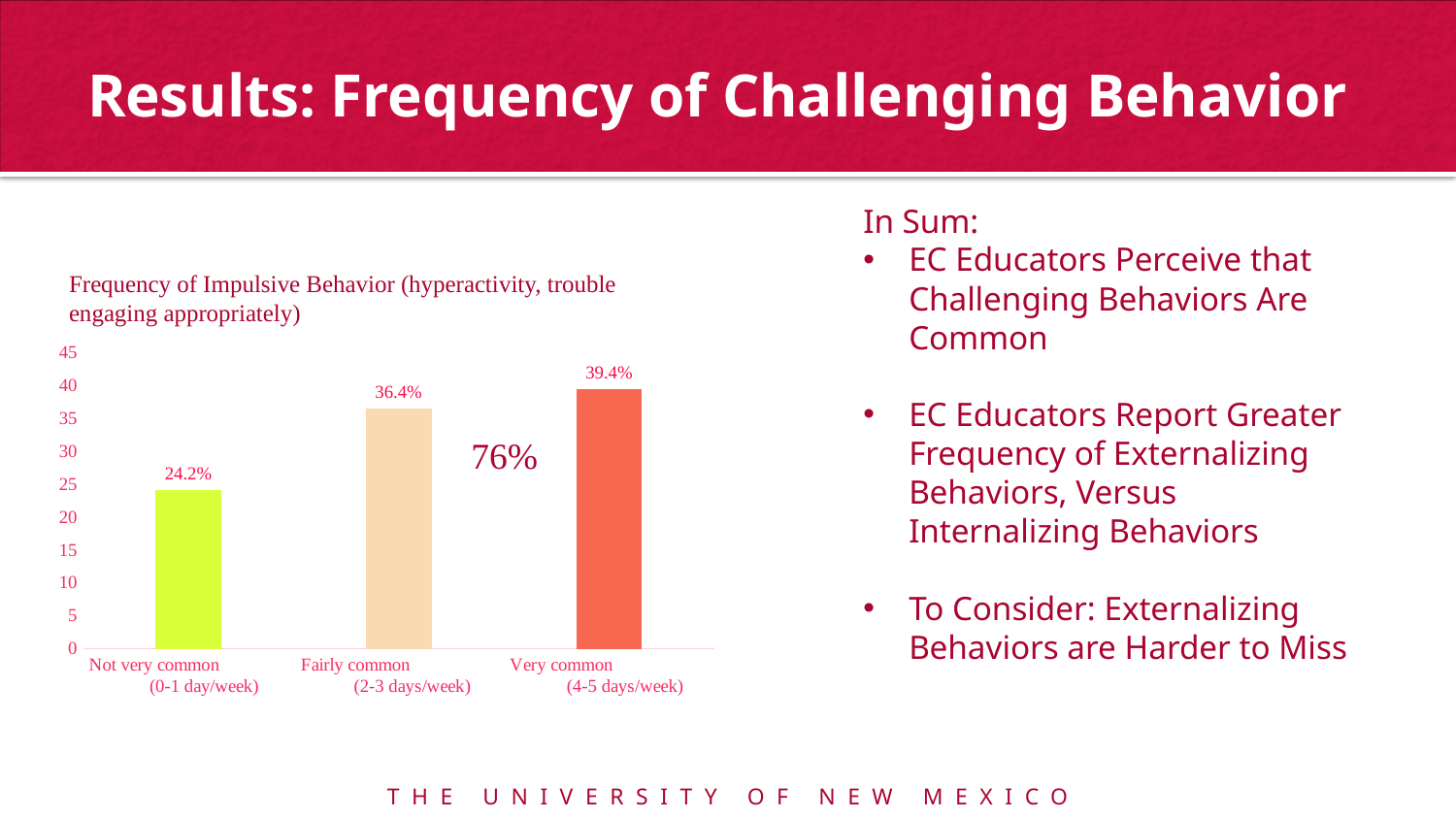
Do the values rise or fall from left to right along the x axis? Rise What kind of chart is this? Bar chart What is the title of the chart? Frequency of Impulsive Behavior (hyperactivity, trouble engaging appropriately) What is the value for "Fairly common (2-3 days/week)"? 36.4% Which category has the highest value? Very common (4-5 days/week) How many categories are shown on the x axis? 3 Which category has the lowest value? Not very common (0-1 day/week) What is the difference between the values for "Very common" and "Not very common"? 15.2% Which is larger, the value for "Fairly common" or "Not very common"? Fairly common What is the difference between the values for "Fairly common" and "Not very common"? 12.2% What is the value for "Not very common (0-1 day/week)"? 24.2% What is the value for "Very common (4-5 days/week)"? 39.4%